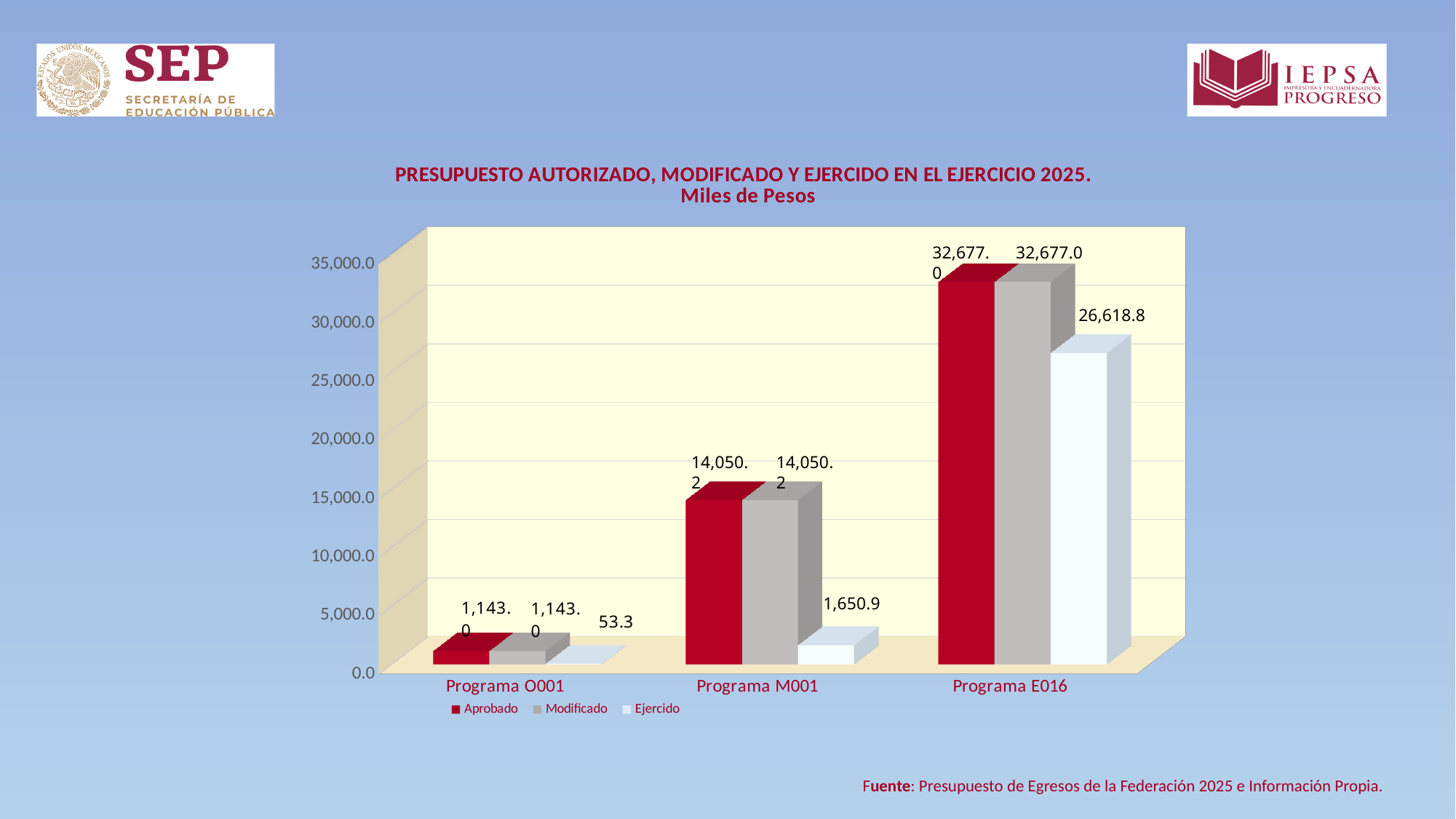
What is the difference between the Modificado and Ejercido values for Programa E016? 6,058.2 What is the Ejercido value for Programa E016? 26,618.8 How many programs are shown on the x axis? 3 How many series does the legend list? 3 What is the Modificado value for Programa E016? 32,677.0 Which program has the lowest Ejercido value? Programa O001 Which program has the highest Aprobado value? Programa E016 What is the Ejercido value for Programa O001? 53.3 What unit is stated in the chart title? Miles de Pesos What is the Aprobado value for Programa M001? 14,050.2 What kind of chart is shown on the slide? Bar chart Which is larger for Programa M001, the Aprobado value or the Ejercido value? Aprobado